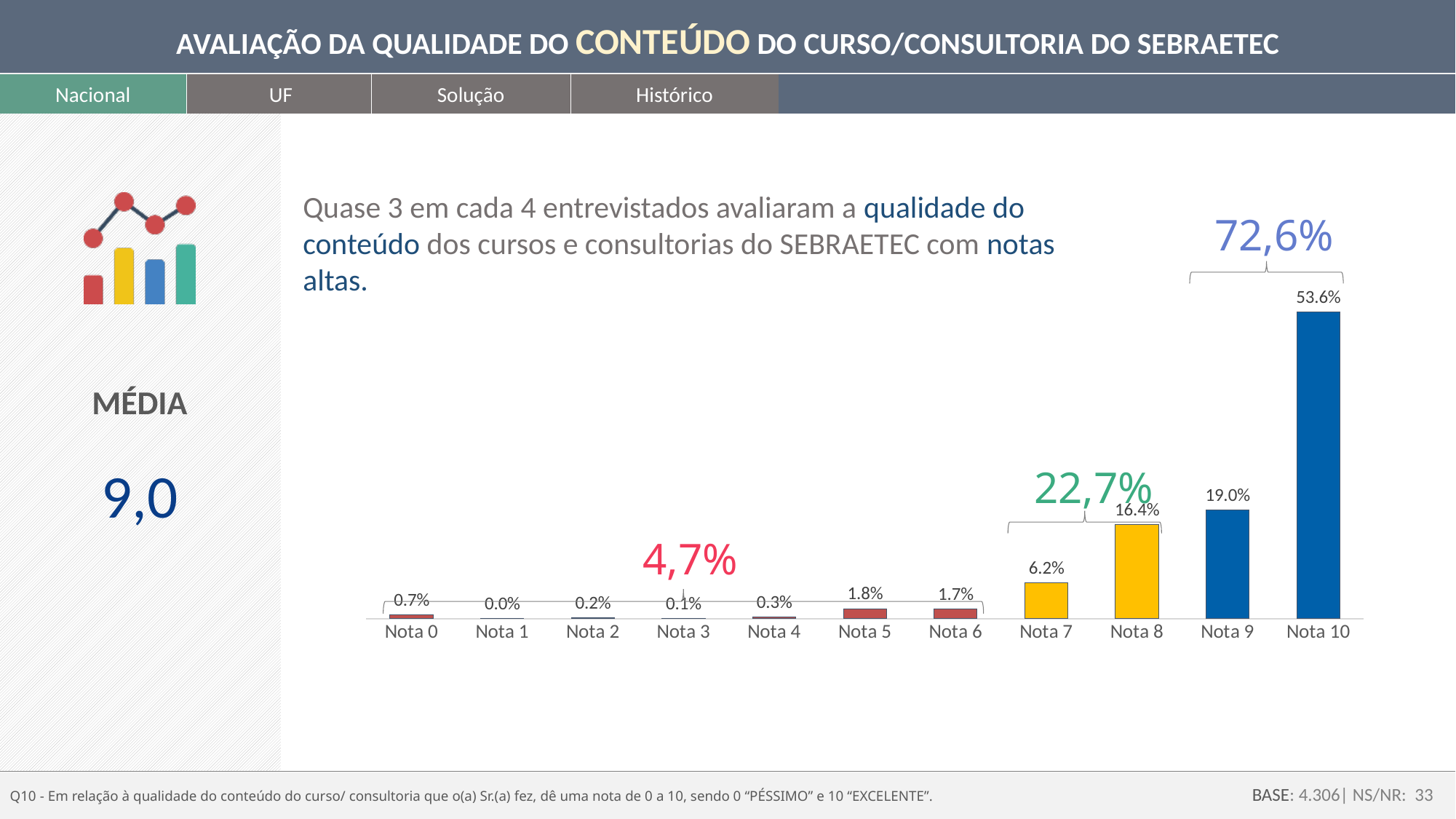
Which category has the lowest value? Nota 1 What is the value for Nota 7? 6.2% Which is larger, the value for Nota 9 or the value for Nota 8? Nota 9 What is the value for Nota 5? 1.8% What combined percentage is shown above the bracket grouping Nota 7 and Nota 8? 22,7% What kind of chart is shown on the slide? Bar chart What combined percentage is shown above the bracket grouping Nota 9 and Nota 10? 72,6% What is the value for Nota 10? 53.6% How many categories are shown on the x axis? 11 What is the value for Nota 8? 16.4% What is the difference between the values for Nota 10 and Nota 9? 34.6% Which category has the highest value? Nota 10